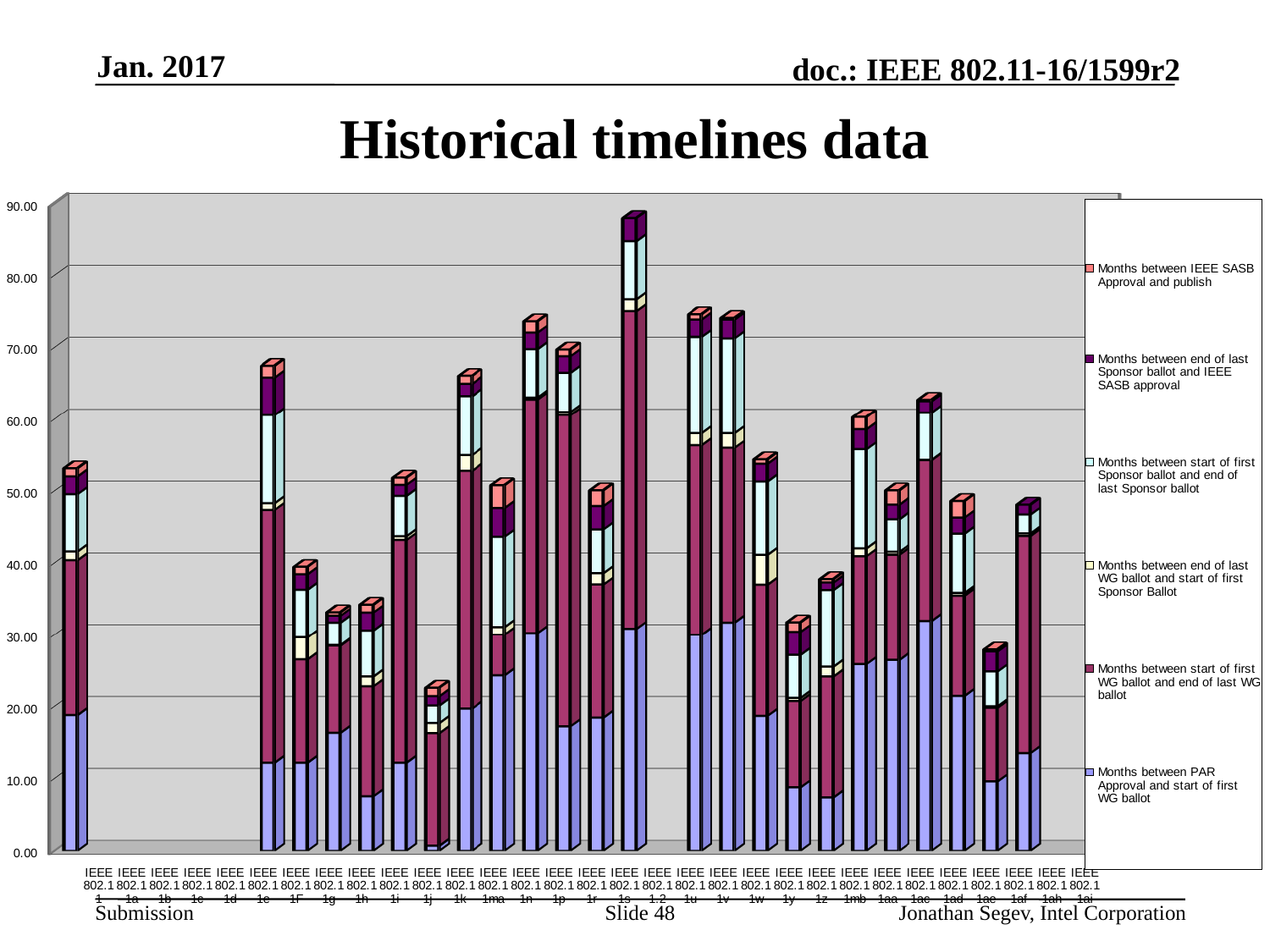
Which has the larger total stacked value, IEEE 802.11n or IEEE 802.11g? IEEE 802.11n Which category has the tallest stacked bar? IEEE 802.11s What is the title of the chart? Historical timelines data Is the 'Months between PAR Approval and start of first WG ballot' value for IEEE 802.11e greater or less than 20? less Is the total stacked value for IEEE 802.11s greater or less than 80? greater Which category has the shortest stacked bar among those with a plotted bar? IEEE 802.11j How many series does the legend list? 6 What kind of chart is shown on the slide? Stacked bar chart Which legend entry corresponds to the bottom segment of each stacked bar? Months between PAR Approval and start of first WG ballot Which has the larger total stacked value, IEEE 802.11s or IEEE 802.11e? IEEE 802.11s Is the total stacked value for IEEE 802.11e greater or less than 60? greater